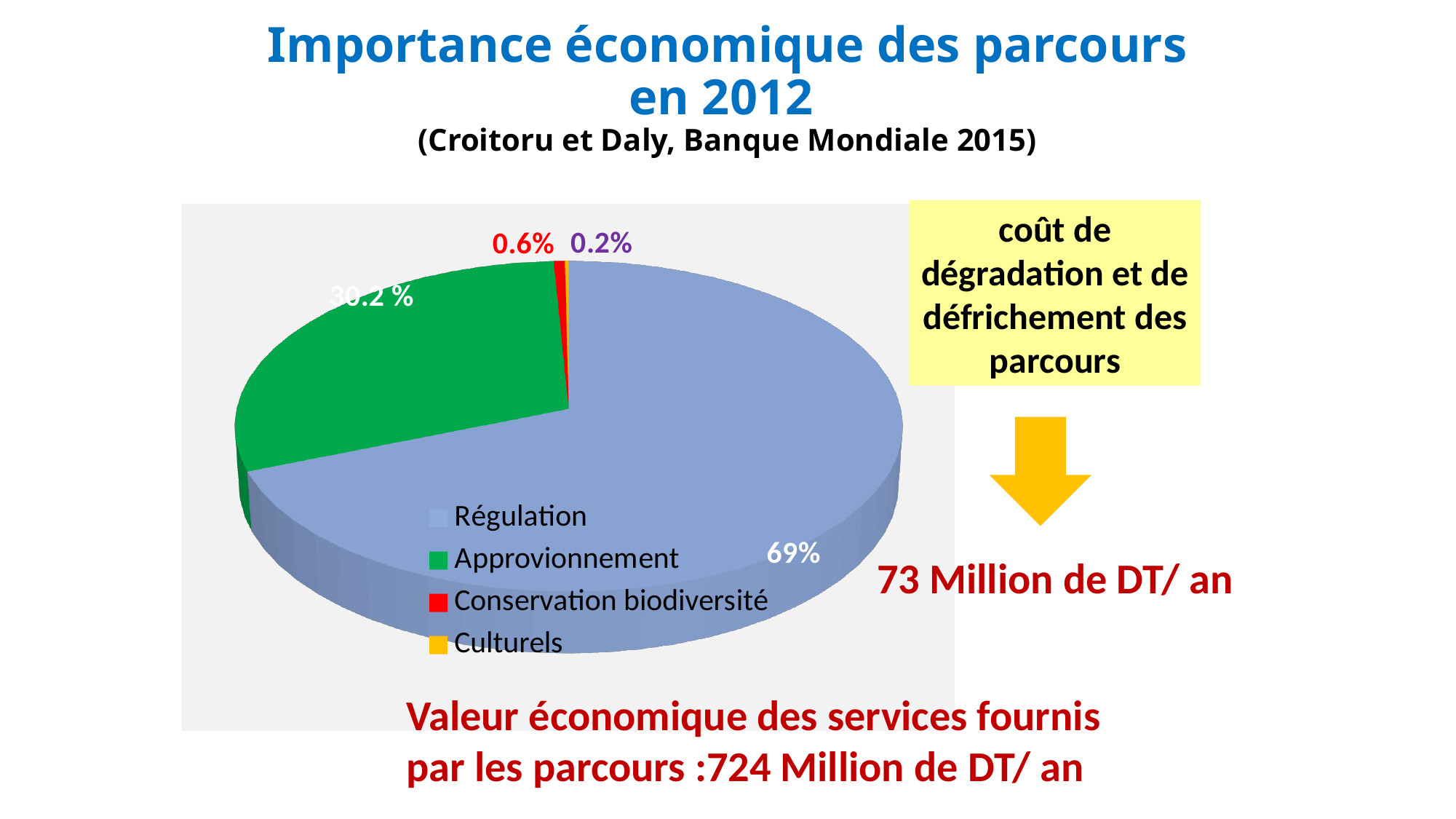
What kind of chart is shown on the slide? pie chart What share of the pie does Conservation biodiversité represent? 0.6% What share of the pie does Culturels represent? 0.2% How many categories does the pie chart have? 4 How many entries does the legend list? 4 Which category has the smallest slice of the pie? Culturels What share of the pie does Approvisionnement represent? 30.2 % Which is larger, the slice for Approvisionnement or the slice for Conservation biodiversité? Approvisionnement What share of the pie does Régulation represent? 69% What colour is the Approvisionnement slice in the pie chart? green How many percentage points larger is the Régulation slice than the Approvisionnement slice? 38.8 Which category has the largest slice of the pie? Régulation